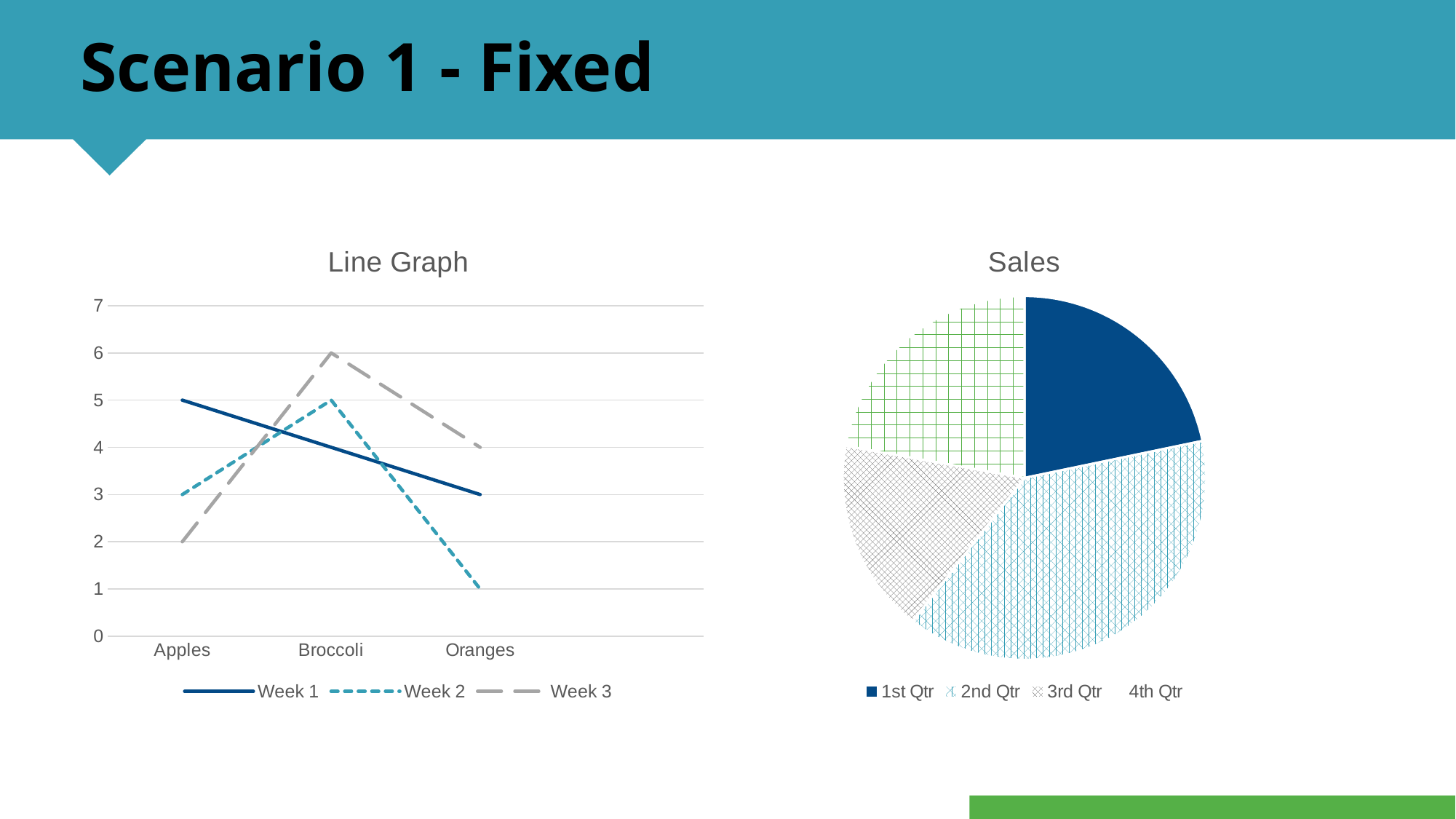
In the "Line Graph" chart, what is the difference between Week 3 and Week 2 at Oranges? 3 In the "Line Graph" chart, what is the value for Week 1 at Apples? 5 In the "Line Graph" chart, does the Week 1 line rise or fall from Apples to Oranges? fall What kind of chart is the "Line Graph" chart on the left? line chart In the "Line Graph" chart, what is the value for Week 3 at Broccoli? 6 In the "Line Graph" chart, what is the value for Week 2 at Oranges? 1 In the "Sales" pie chart, which quarter has the largest slice? 2nd Qtr In the "Line Graph" chart, which category has the highest value for Week 2? Broccoli What kind of chart is the "Sales" chart on the right? pie chart In the "Line Graph" chart, which category has the lowest value for Week 3? Apples In the "Line Graph" chart, how many series does the legend list? 3 In the "Sales" pie chart, how many slices does the legend list? 4